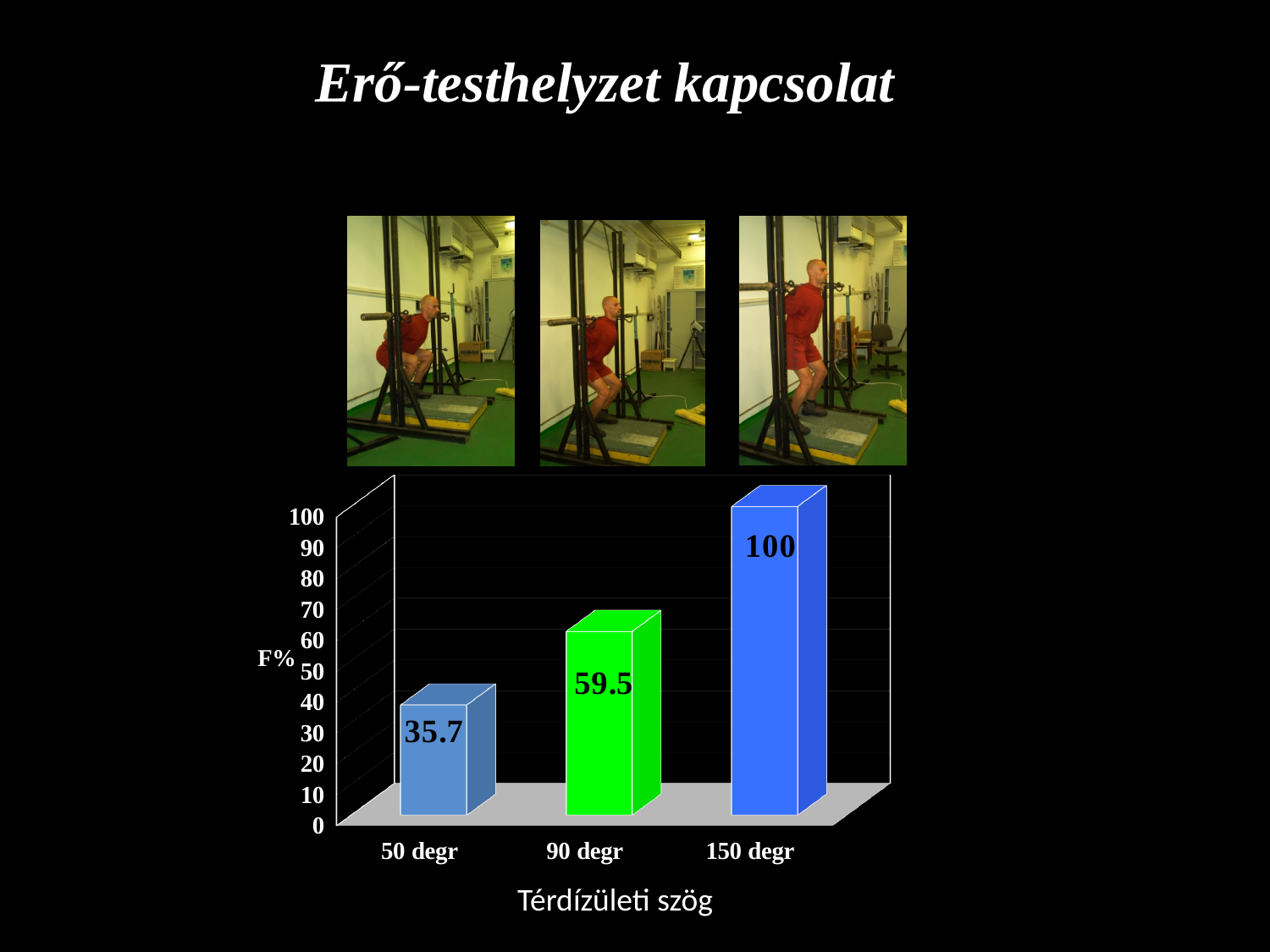
What is the F% value for 50 degr? 35.7 Which has a larger F% value, 50 degr or 90 degr? 90 degr How many knee angle categories are shown in the chart? 3 What is the difference in F% between 90 degr and 50 degr? 23.8 Which knee angle has the lowest F% value? 50 degr Do the F% values rise or fall as the knee angle increases from 50 degr to 150 degr? rise Which knee angle has the highest F% value? 150 degr What is the F% value for 150 degr? 100 What is the difference in F% between 150 degr and 90 degr? 40.5 What is the label of the x axis of the chart? Térdízületi szög What is the F% value for 90 degr? 59.5 What kind of chart is shown on the slide? bar chart